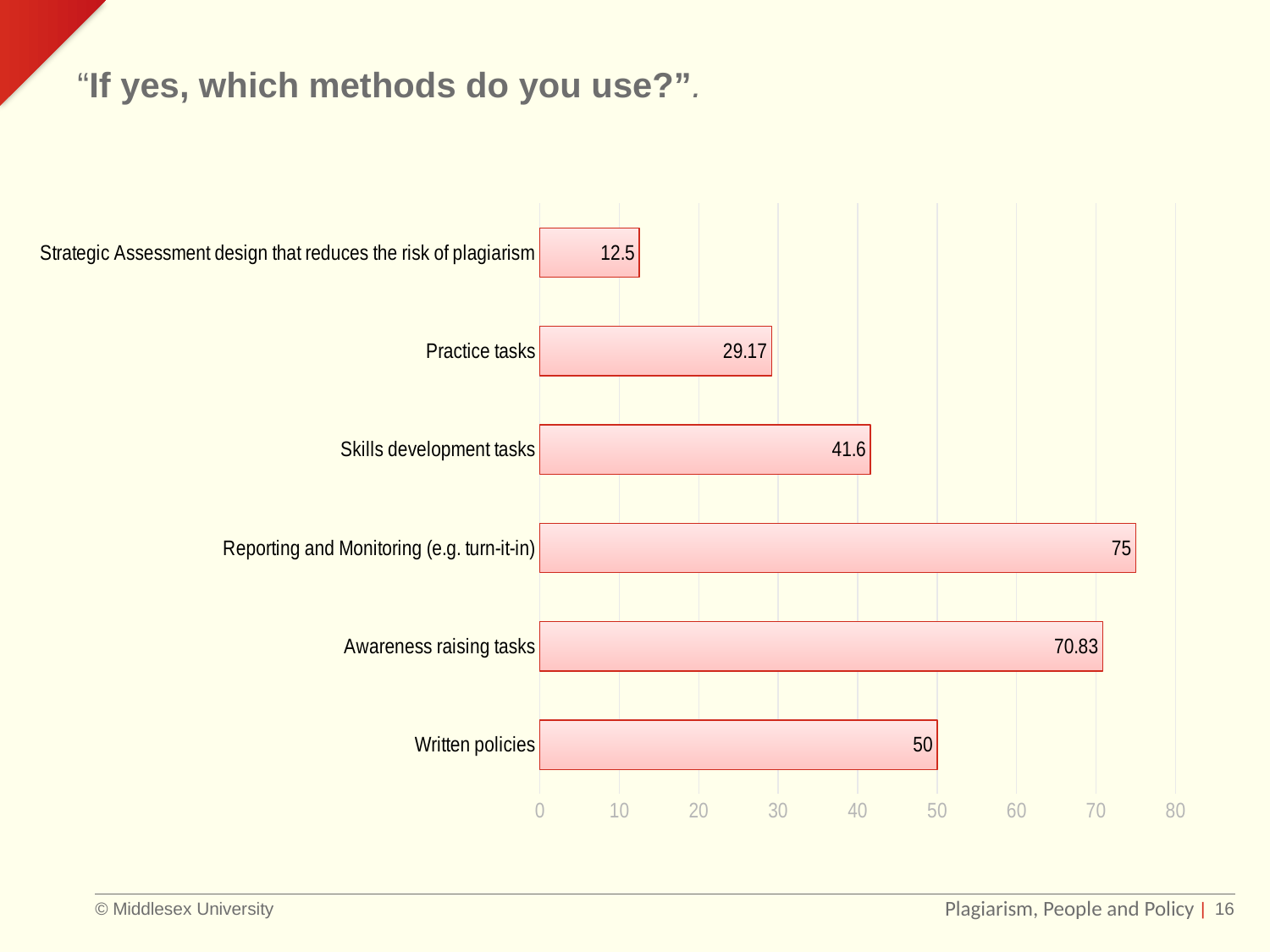
What is the difference between the values for Written policies and Strategic Assessment design that reduces the risk of plagiarism? 37.5 What is the value for Reporting and Monitoring (e.g. turn-it-in)? 75 What is the value for Practice tasks? 29.17 Which is larger, the value for Awareness raising tasks or the value for Written policies? Awareness raising tasks What is the value for Written policies? 50 What kind of chart is shown on the slide? bar chart Which category has the lowest value? Strategic Assessment design that reduces the risk of plagiarism Which category has the highest value? Reporting and Monitoring (e.g. turn-it-in) What is the value for Awareness raising tasks? 70.83 How many categories are shown in the chart? 6 What is the value for Skills development tasks? 41.6 Is the value for Skills development tasks greater or less than 40? greater